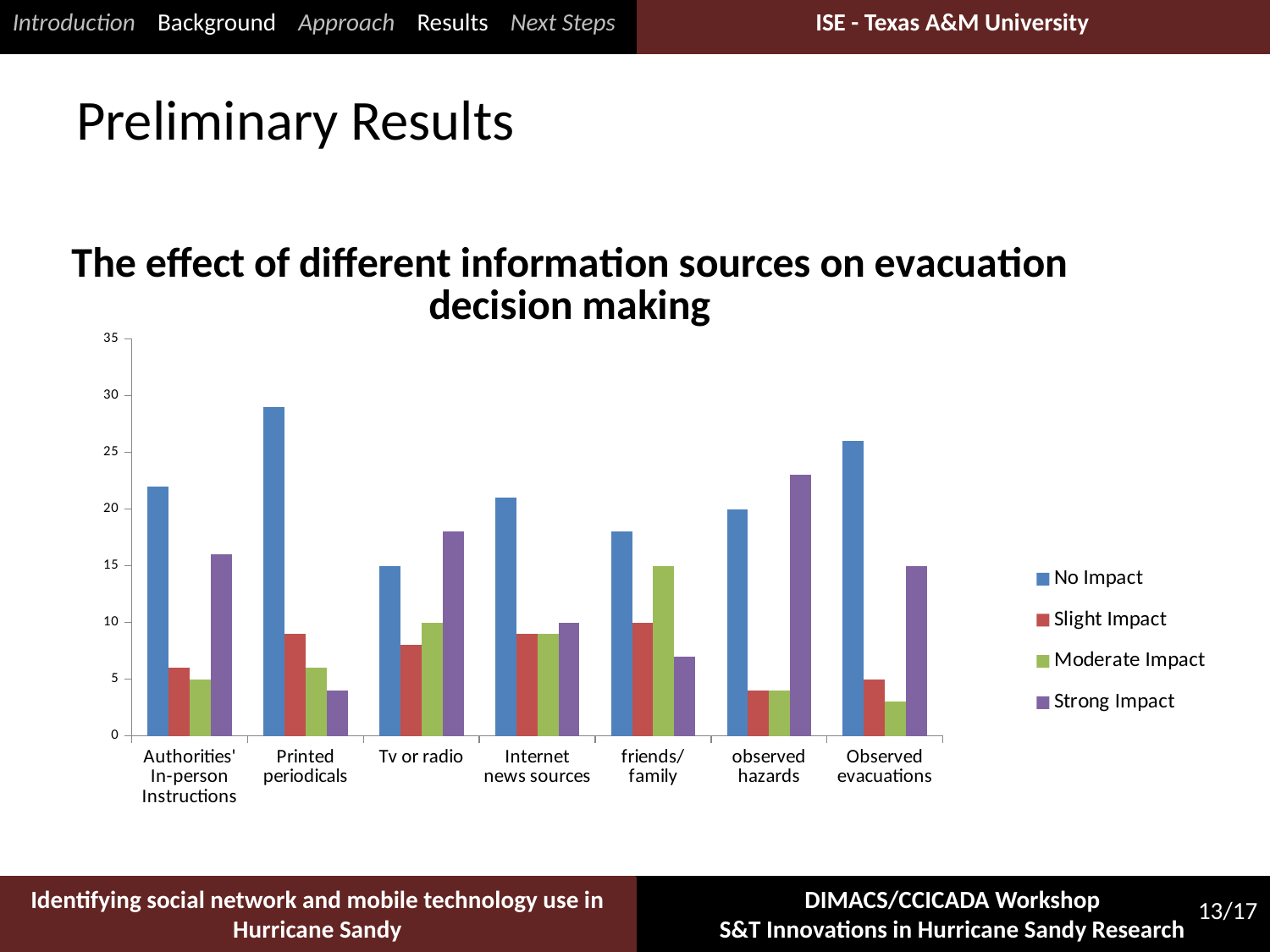
For Observed evacuations, which is larger: the No Impact bar or the Strong Impact bar? No Impact Is the Strong Impact value for Printed periodicals greater or less than 5? less For observed hazards, which is larger: the No Impact bar or the Strong Impact bar? Strong Impact How many information source categories are shown on the x axis? 7 Is the No Impact value for Printed periodicals greater or less than 25? greater Which information source has the highest Strong Impact bar? observed hazards What is the title of the chart? The effect of different information sources on evacuation decision making What type of chart is shown on the slide? bar chart Which information source has the highest Moderate Impact bar? friends/ family How many series does the legend list? 4 Which information source has the highest No Impact bar? Printed periodicals Is the Strong Impact value for observed hazards greater or less than 20? greater